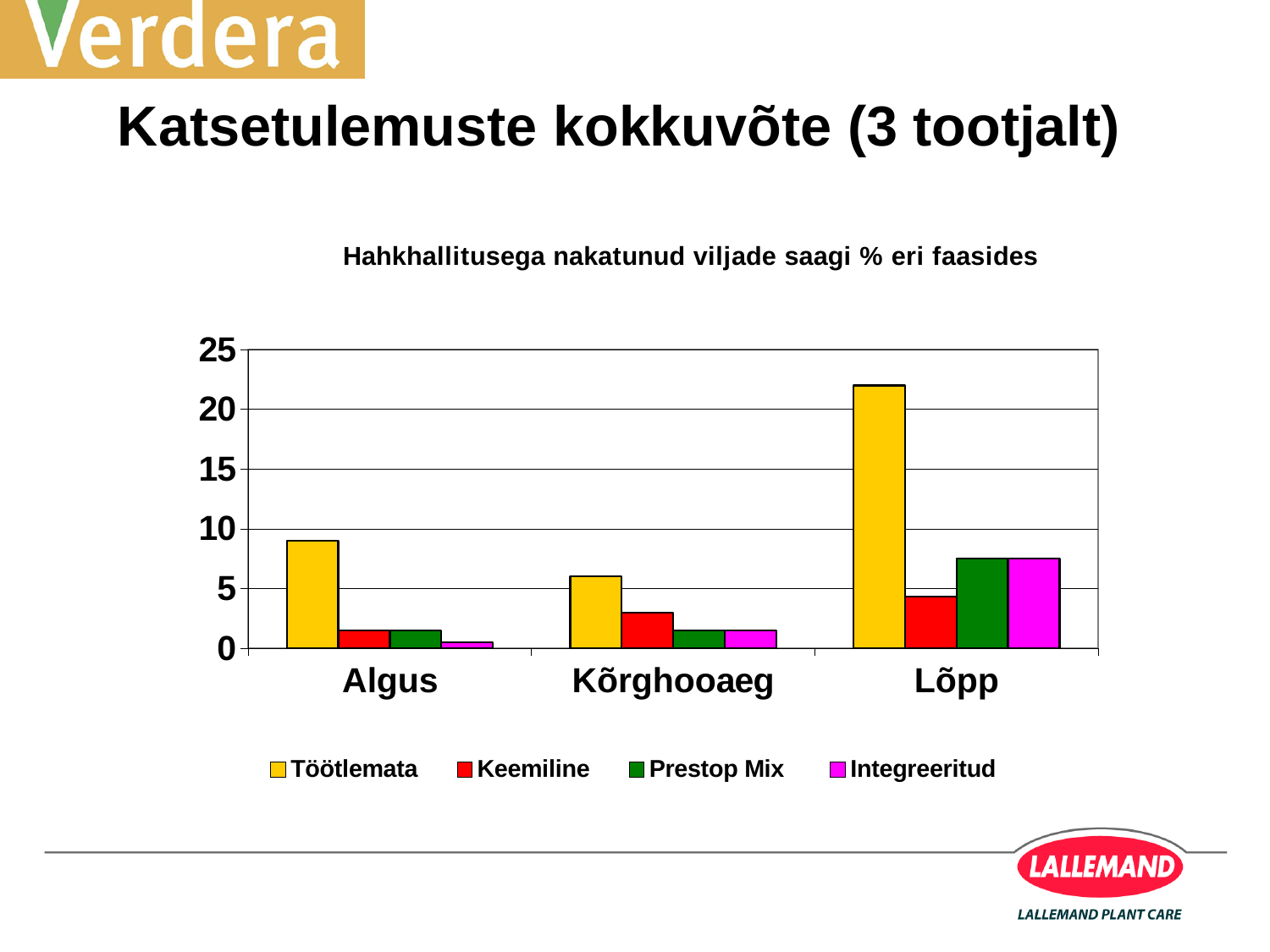
Is the Töötlemata value for Algus greater or less than 10? less What is the title of the chart? Hahkhallitusega nakatunud viljade saagi % eri faasides Which is larger for Kõrghooaeg, the Töötlemata value or the Keemiline value? Töötlemata How many categories are shown on the x axis? 3 Is the Töötlemata value for Lõpp greater or less than 20? greater Which category has the highest Töötlemata value? Lõpp Is the Keemiline value for Lõpp greater or less than 5? less Which category has the lowest Töötlemata value? Kõrghooaeg How many series does the legend list? 4 Which series has the highest value in the Lõpp category? Töötlemata What kind of chart is shown on the slide? bar chart